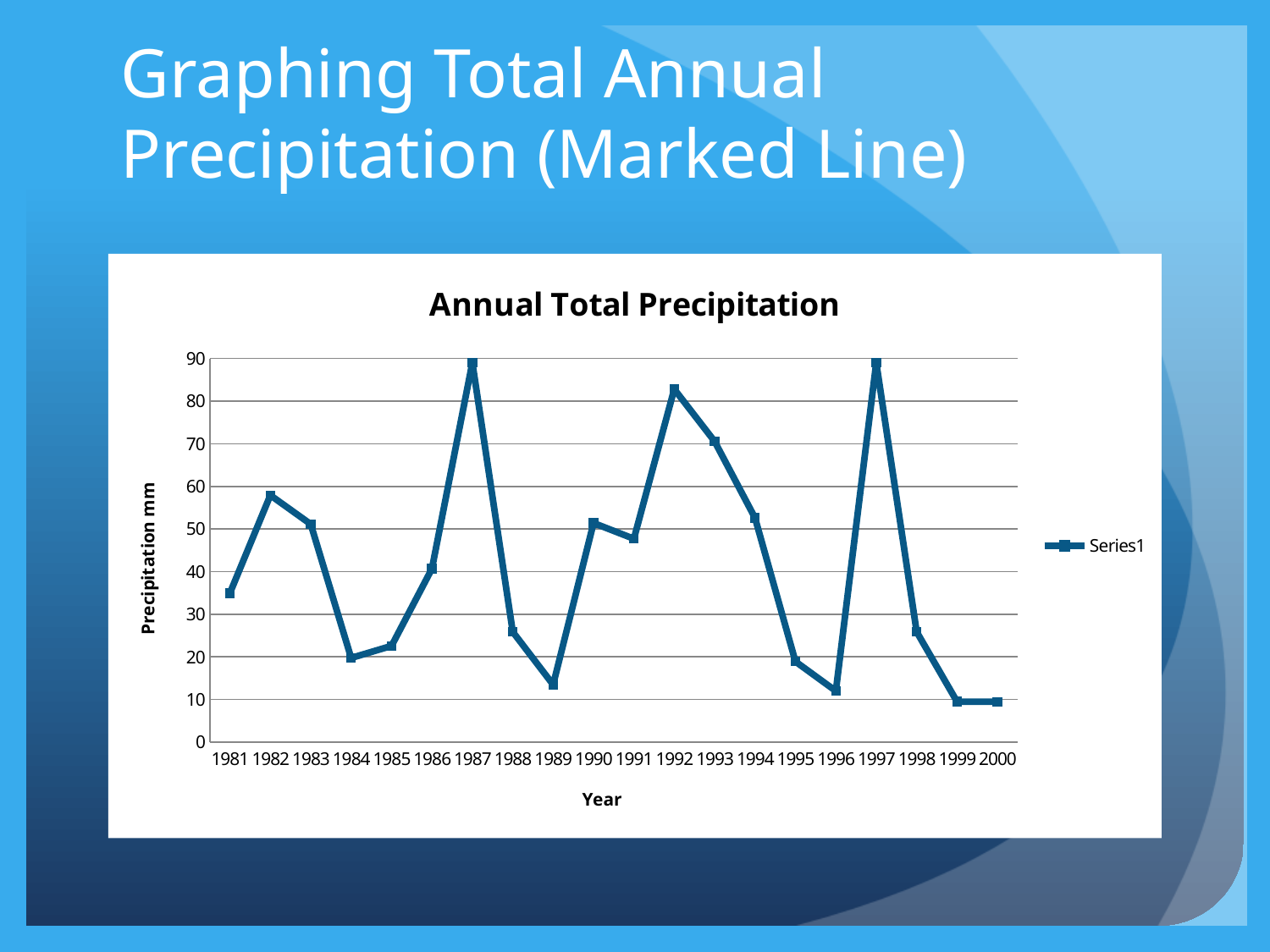
What is the label of the y axis? Precipitation mm Do the values rise or fall from 1992 to 1996? fall How many series does the legend list? 1 What kind of chart is shown on the slide? line chart Which year has the larger value, 1992 or 1984? 1992 What is the title of the chart? Annual Total Precipitation How many years are plotted on the x axis of the chart? 20 Is the value for 1987 greater or less than 80? greater Which year has the larger value, 1982 or 1996? 1982 Is the value for 1999 greater or less than 20? less Is the value for 1989 greater or less than 20? less